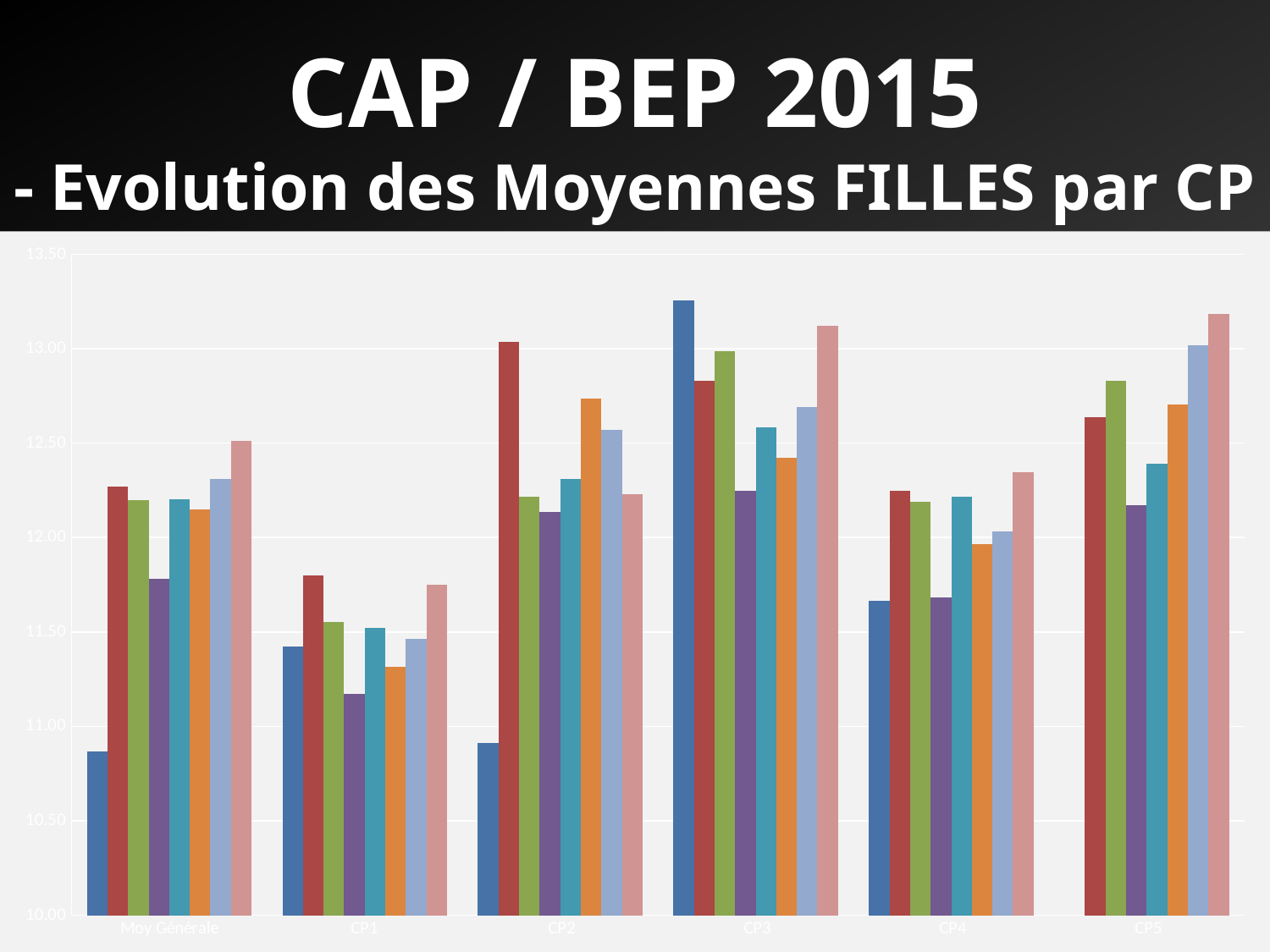
Within the CP1 group, which bar is the tallest? the red bar Is the value of the last (pink) bar for CP5 greater or less than 13.00? greater What is the title of the slide above the chart? CAP / BEP 2015 - Evolution des Moyennes FILLES par CP What kind of chart is shown on the slide? bar chart How many categories are shown along the x axis? 6 Is the value of the first (blue) bar for CP4 greater or less than 11.50? greater Which category contains the tallest bar in the chart? CP3 Is the value of the first (blue) bar for CP3 greater or less than 13.00? greater What is the highest value shown on the vertical axis? 13.50 Which is larger: the first (blue) bar for CP3 or the first (blue) bar for CP1? CP3